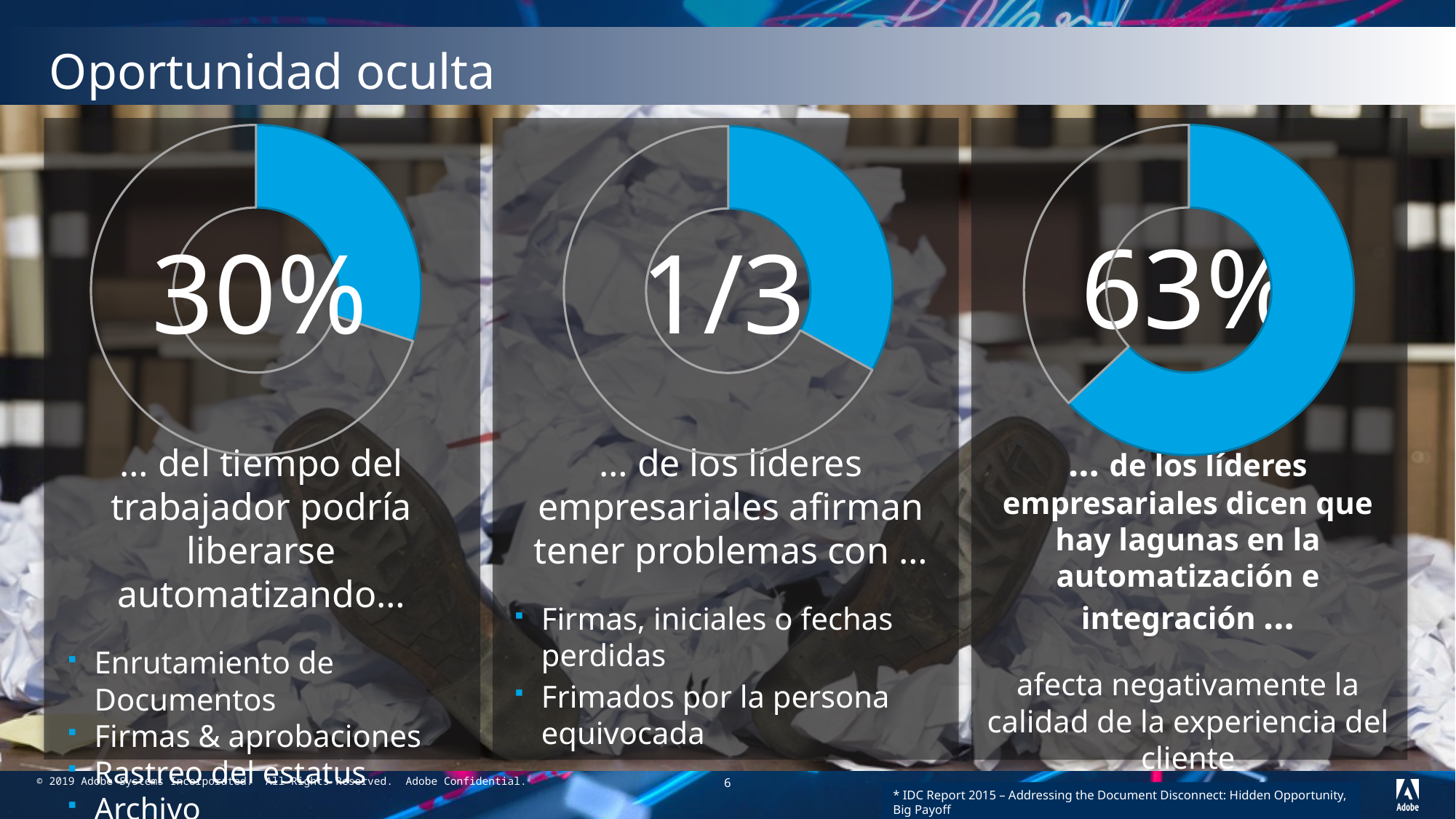
How many donut charts are on the slide? 3 What value is shown in the centre of the middle donut chart? 1/3 What value is shown in the centre of the left donut chart? 30% What kind of chart is used three times on this slide? Donut chart Which donut chart shows the largest highlighted share: the left, middle or right one? Right Is the value shown in the right donut chart greater or less than 50%? greater Is the value shown in the left donut chart greater or less than 50%? less Is the highlighted share in the right donut chart larger or smaller than the one in the left donut chart? Larger What is the title of the slide containing the three donut charts? Oportunidad oculta What value is shown in the centre of the right donut chart? 63% Which donut chart shows the smallest highlighted share: the left, middle or right one? Left What colour is the highlighted segment in each donut chart? Blue